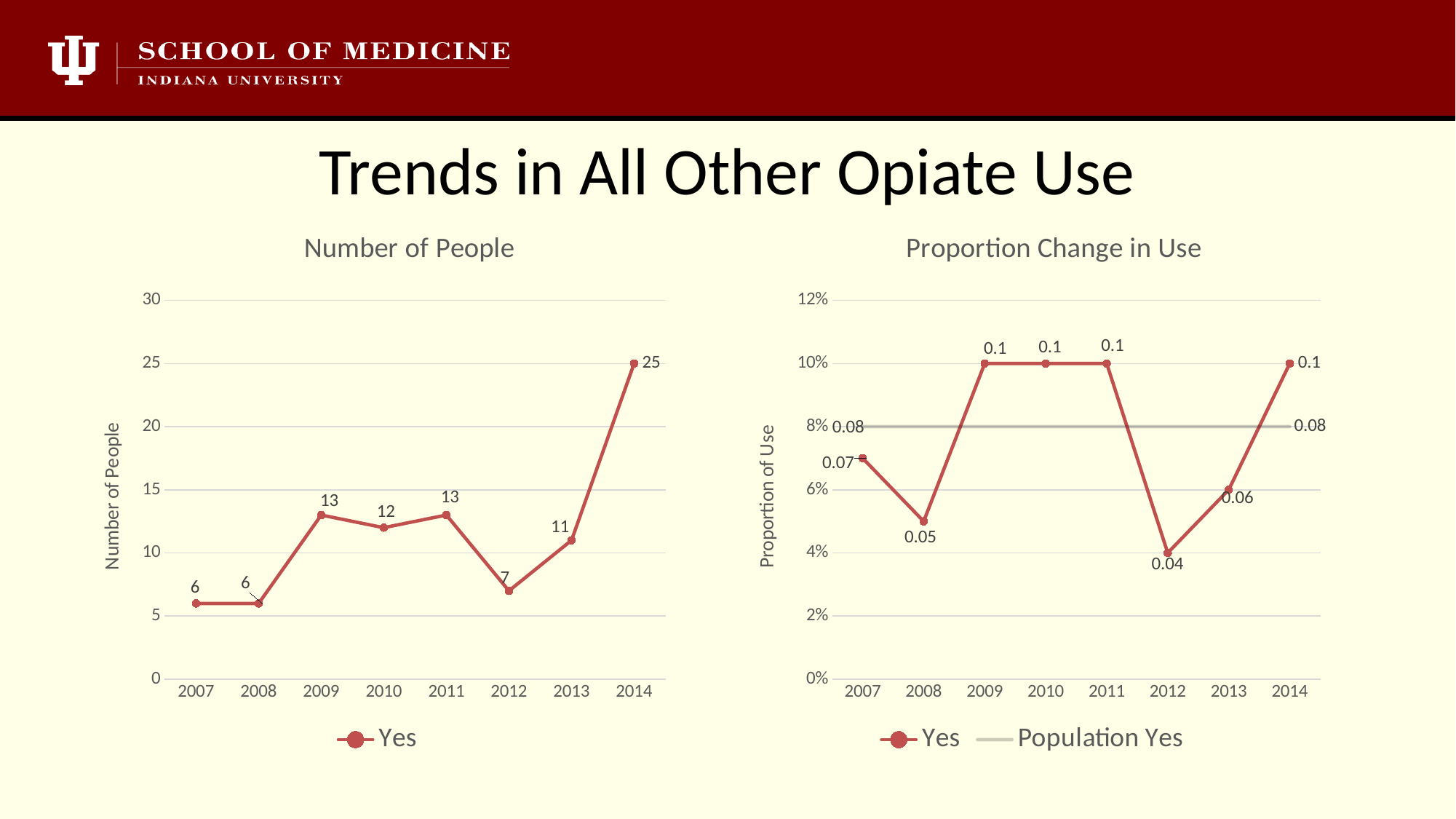
In the 'Number of People' chart, what is the difference between the values for 2014 and 2013? 14 In the 'Proportion Change in Use' chart, which year has the lowest 'Yes' value? 2012 In the 'Proportion Change in Use' chart, what is the value of the 'Population Yes' line? 0.08 In the 'Number of People' chart, how many years are plotted on the x axis? 8 In the 'Number of People' chart, what is the value for 2012? 7 In the 'Number of People' chart, which year has the highest value? 2014 In the 'Number of People' chart, which is larger, the value for 2009 or the value for 2010? 2009 What kind of chart is the 'Number of People' chart? Line chart In the 'Number of People' chart, what is the value for 2014? 25 How many series does the legend of the 'Proportion Change in Use' chart list? 2 In the 'Proportion Change in Use' chart, what is the 'Yes' value for 2008? 0.05 In the 'Proportion Change in Use' chart, what is the 'Yes' value for 2012? 0.04